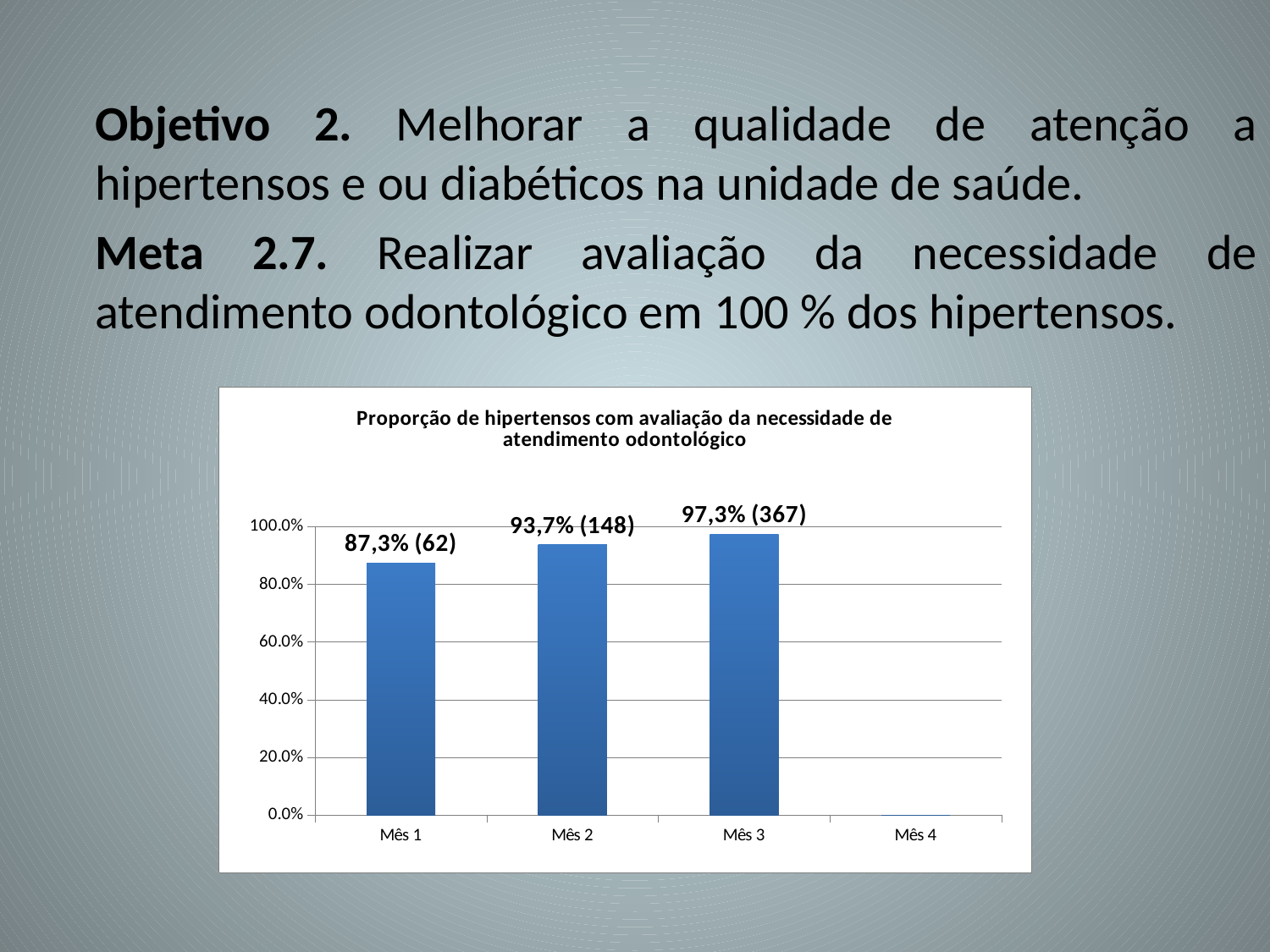
Is the value for Mês 1 greater or less than 80.0%? greater How many bars are plotted in the chart? 3 What is the value shown for Mês 3? 97,3% (367) Which is larger, the value for Mês 2 or the value for Mês 3? Mês 3 What kind of chart is shown on the slide? Bar chart Which month has the highest proportion? Mês 3 Which month with a plotted bar has the lowest proportion? Mês 1 Do the values rise or fall from Mês 1 to Mês 3? Rise What is the value shown for Mês 2? 93,7% (148) What is the difference in percentage points between Mês 2 and Mês 1? 6,4 percentage points What is the value shown for Mês 1? 87,3% (62) What is the difference in percentage points between Mês 3 and Mês 1? 10,0 percentage points